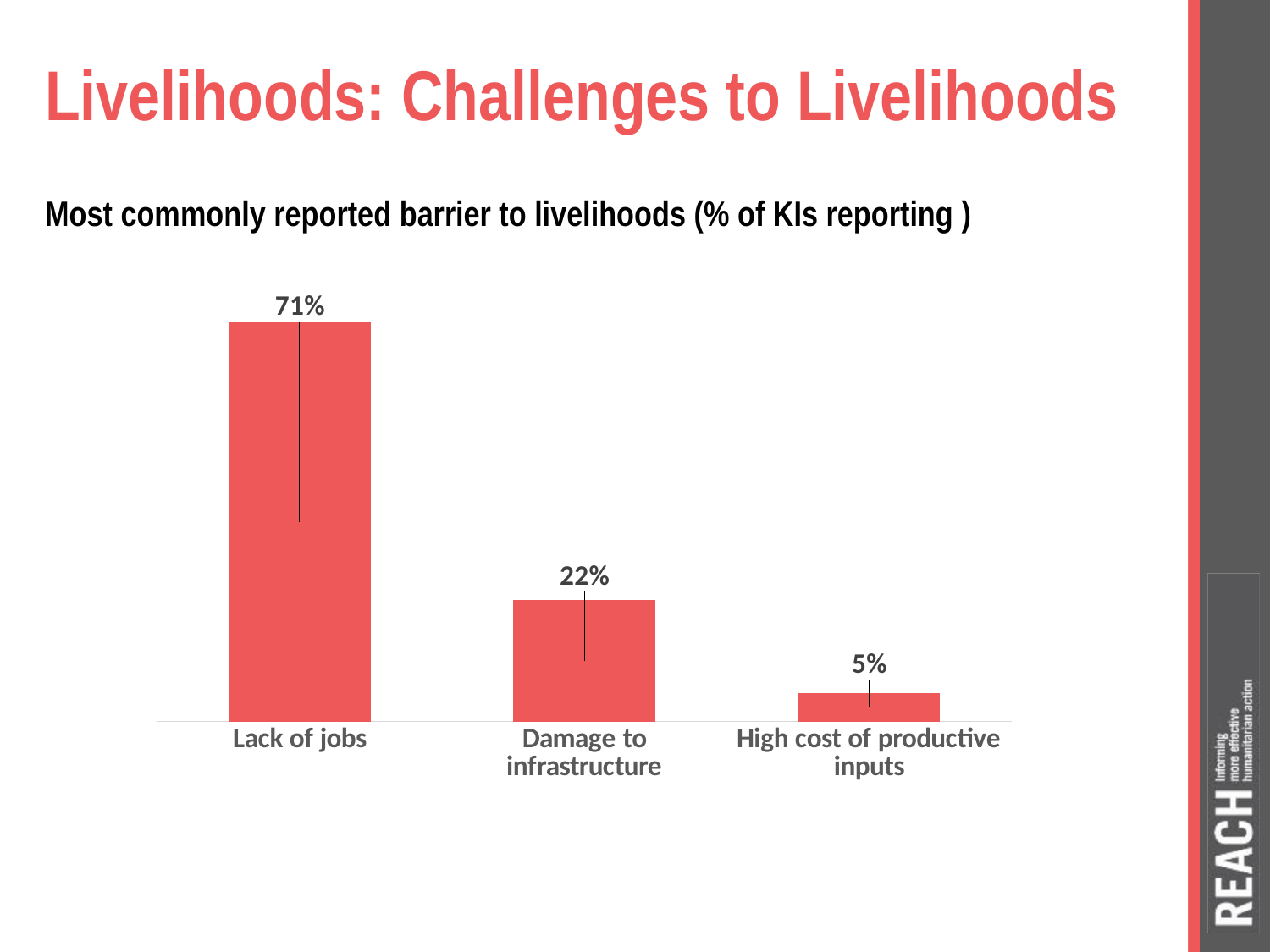
What is the difference in percentage points between damage to infrastructure and high cost of productive inputs? 17 What percentage of KIs reported high cost of productive inputs as a barrier to livelihoods? 5% Which barrier to livelihoods was reported by the highest percentage of KIs? Lack of jobs Which barrier to livelihoods was reported by the lowest percentage of KIs? High cost of productive inputs What type of chart is used on this slide? Bar chart What is the difference in percentage points between lack of jobs and damage to infrastructure? 49 Do the values rise or fall moving from left to right across the categories? Fall Which was reported by more KIs: damage to infrastructure or high cost of productive inputs? Damage to infrastructure How many barriers to livelihoods are shown in the chart? 3 What is the title of the chart on this slide? Most commonly reported barrier to livelihoods (% of KIs reporting ) What percentage of KIs reported damage to infrastructure as a barrier to livelihoods? 22% What percentage of KIs reported lack of jobs as a barrier to livelihoods? 71%